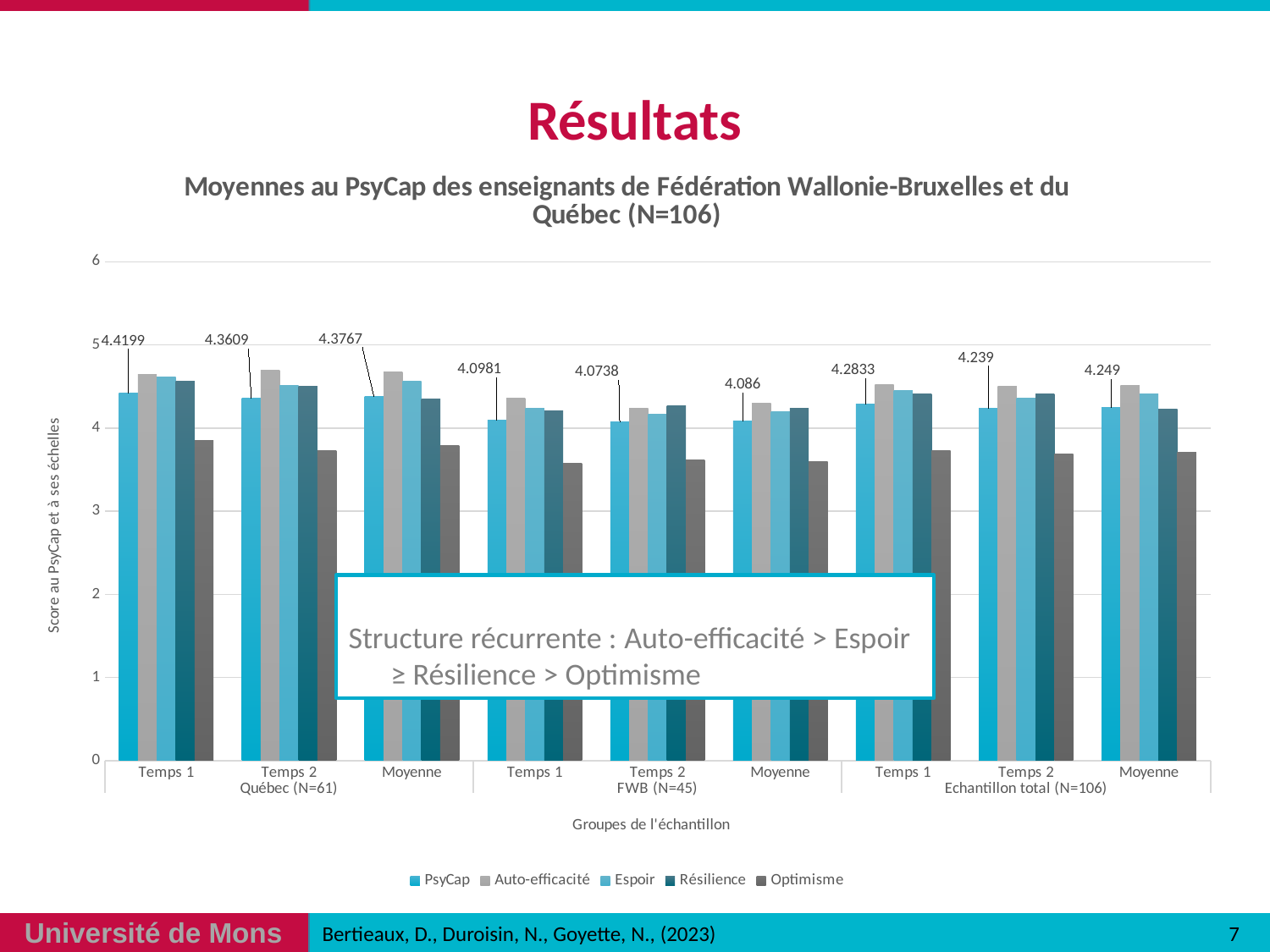
How many series does the legend list? 5 Does the PsyCap value rise or fall from Temps 1 to Temps 2 in the Québec (N=61) group? fall Is the Optimisme value for Temps 1 in the Québec (N=61) group greater or less than 4? less What is the difference between the PsyCap values for Temps 1 Québec (N=61) and Temps 2 FWB (N=45)? 0.3461 What is the PsyCap value for Moyenne in the FWB (N=45) group? 4.086 What is the PsyCap value for Temps 1 in the Québec (N=61) group? 4.4199 Which category has the highest PsyCap value? Temps 1, Québec (N=61) Which is larger: the PsyCap value for Temps 1 in Québec (N=61) or for Temps 1 in FWB (N=45)? Temps 1 in Québec (N=61) What kind of chart is shown on the slide? bar chart Which category has the lowest PsyCap value? Temps 2, FWB (N=45) What is the PsyCap value for Temps 2 in the Echantillon total (N=106) group? 4.239 How many category groups are shown on the x axis? 9